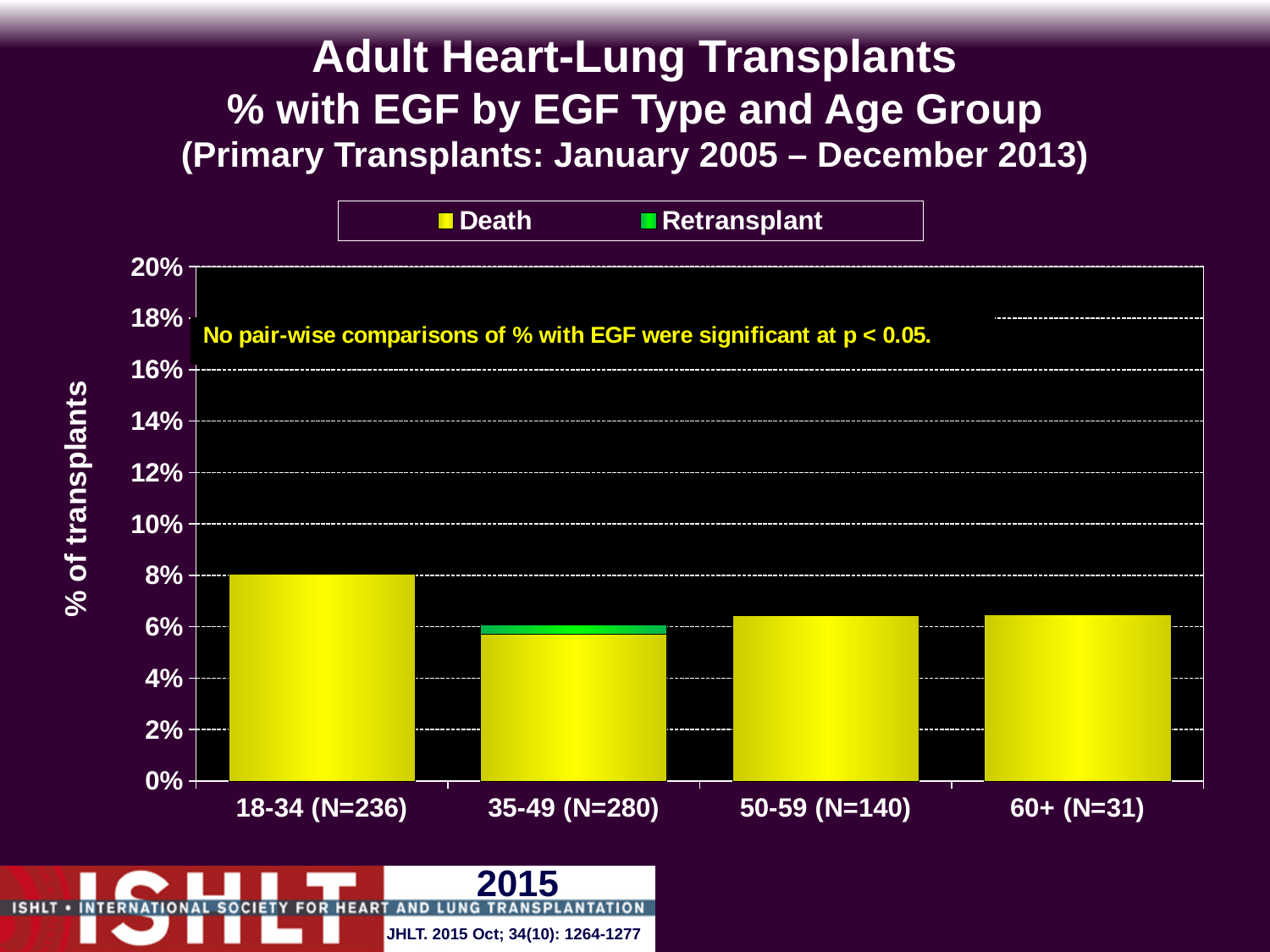
Which age group has the highest % of transplants with EGF? 18-34 (N=236) How many age groups are shown on the x axis? 4 What is the label of the y axis? % of transplants Is the value for the 18-34 (N=236) age group greater or less than 10%? less What kind of chart is shown on the slide? bar chart Is the value for the 60+ (N=31) age group greater or less than 8%? less What are the two series listed in the legend? Death and Retransplant Is the value for the 18-34 (N=236) age group greater or less than 6%? greater Which is larger, the value for 18-34 (N=236) or the value for 35-49 (N=280)? 18-34 (N=236) How many series does the legend list? 2 Which age group is the only one showing a Retransplant segment? 35-49 (N=280)